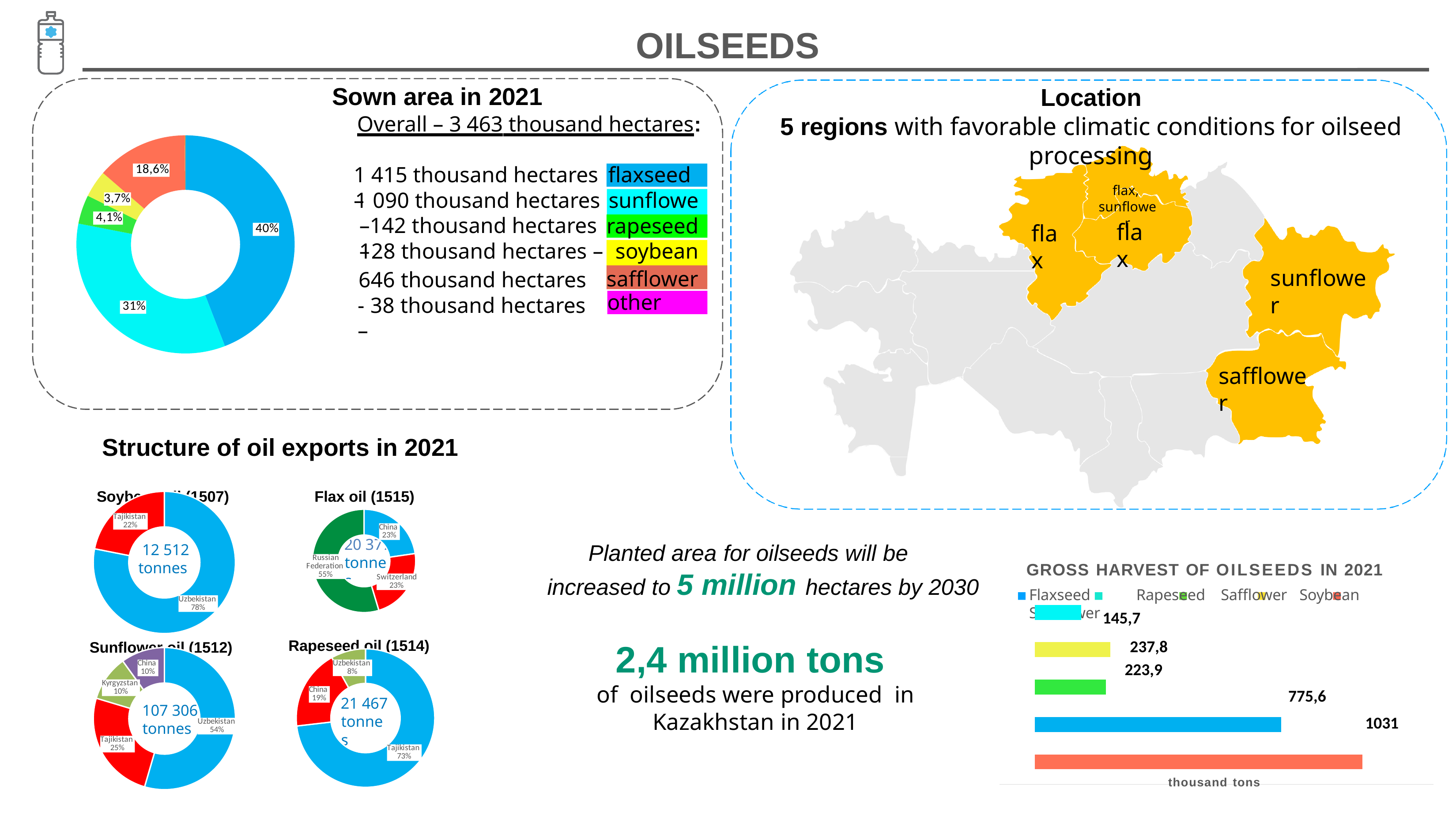
In the 'Flax oil (1515)' donut chart, what share is shown for the Russian Federation? 55% In the 'Sunflower oil (1512)' donut chart, how many countries are shown? 4 In the 'Sown area in 2021' donut chart, what is the difference in percentage points between the flaxseed slice and the sunflower slice? 9 In the 'Sown area in 2021' donut chart, which crop has the largest slice? flaxseed In the 'Rapeseed oil (1514)' donut chart, which country has the largest share? Tajikistan In the 'Sown area in 2021' donut chart, what share is shown for the sunflower (cyan) slice? 31% In the 'Soybean oil (1507)' donut chart, what share is shown for Uzbekistan? 78% In the 'GROSS HARVEST OF OILSEEDS IN 2021' chart, what is the value of the shortest (top, cyan) bar? 145,7 In the 'Sown area in 2021' donut chart, what share is shown for the flaxseed (blue) slice? 40% What kind of chart is 'GROSS HARVEST OF OILSEEDS IN 2021'? bar chart In the 'GROSS HARVEST OF OILSEEDS IN 2021' chart, what is the value of the longest (bottom, salmon) bar? 1031 In the 'Soybean oil (1507)' donut chart, what total quantity is printed in the centre? 12 512 tonnes